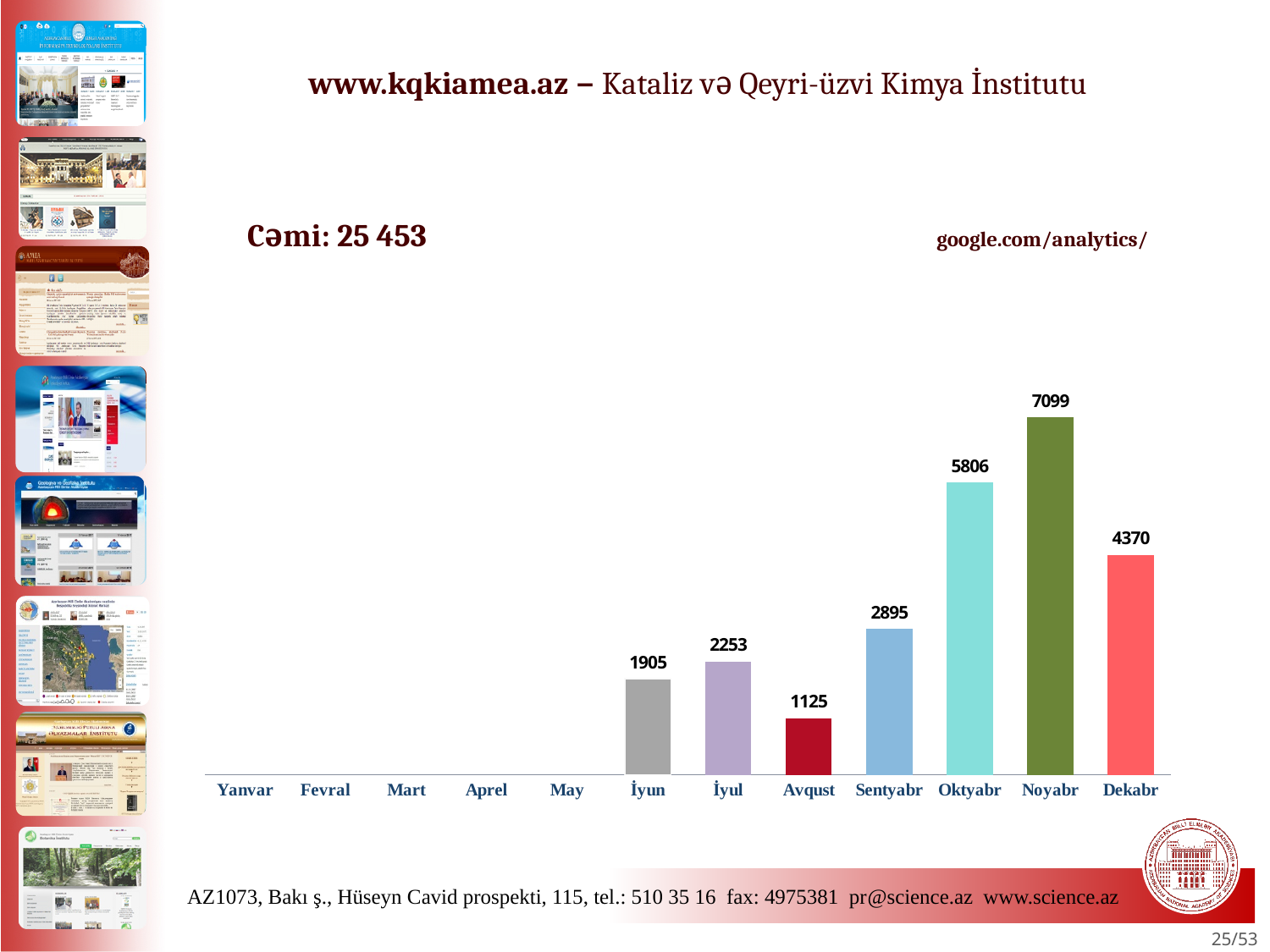
What is the value for Sentyabr? 2895 What is the value for Avqust? 1125 What is the value for Dekabr? 4370 What is the difference between the values for Noyabr and Oktyabr? 1293 Which month has the highest value? Noyabr Which month with a plotted bar has the lowest value? Avqust Which is larger, the value for Dekabr or the value for Sentyabr? Dekabr What is the difference between the values for İyul and İyun? 348 What kind of chart is shown? Bar chart How many months have a bar plotted? 7 How many months are labelled on the x axis? 12 What is the value for Noyabr? 7099